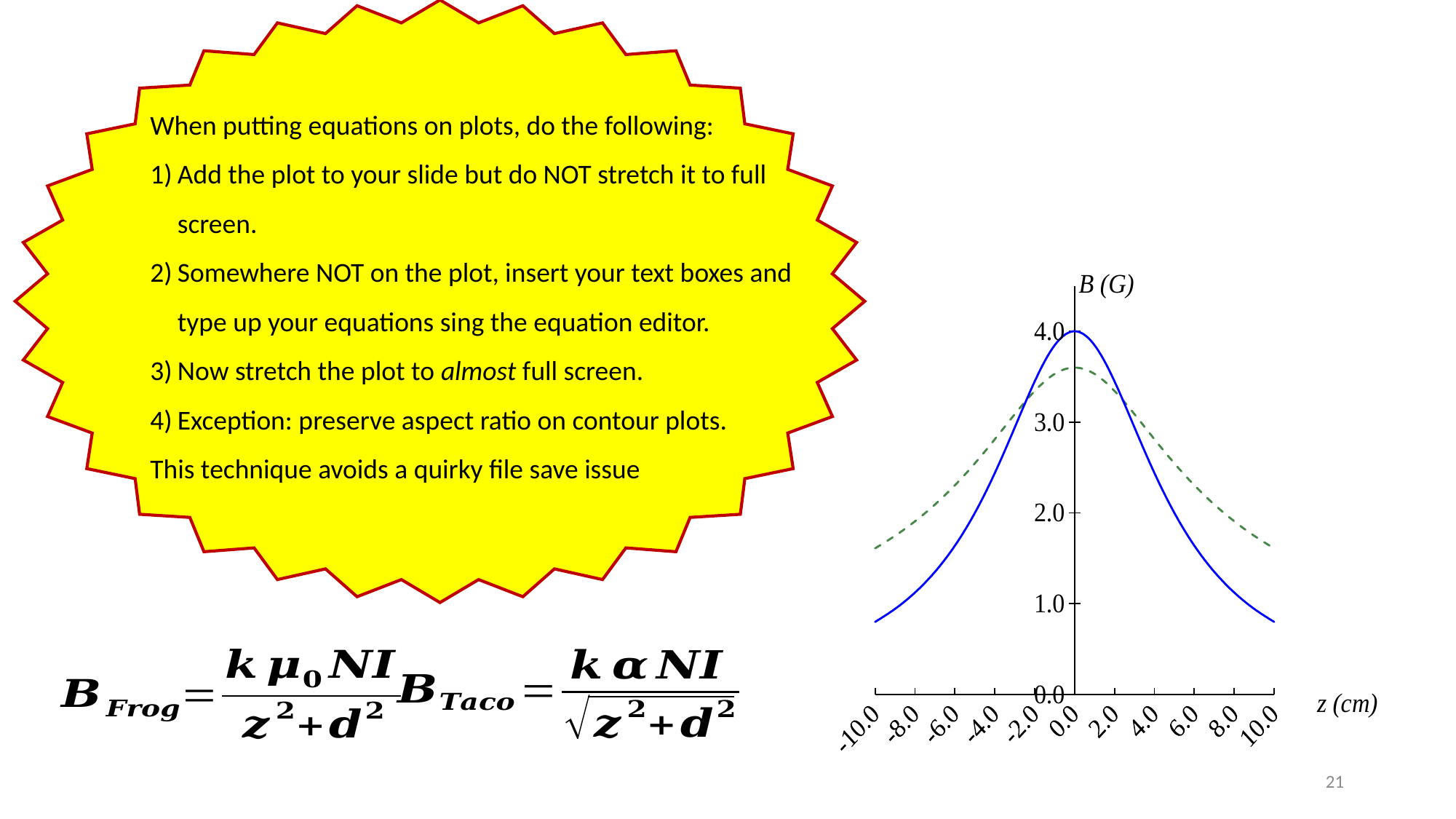
Is the value of the solid blue curve at z = 10.0 greater or less than 1.0? less At z = 10.0, which curve has the higher value, the solid blue curve or the dashed green curve? dashed green curve How many curves are plotted on the chart? 2 Is the value of the dashed green curve at z = 0.0 greater or less than 3.0? greater What kind of chart is shown on the right of the slide? line chart At z = 0.0, which curve has the higher value, the solid blue curve or the dashed green curve? solid blue curve Is the value of the dashed green curve at z = -10.0 greater or less than 1.0? greater Does the solid blue curve rise or fall as z increases from 0.0 to 10.0? fall What is the label of the horizontal axis of the chart? z (cm) What is the peak value of the solid blue curve, at z = 0.0? 4.0 What is the label of the vertical axis of the chart? B (G) How many tick labels are shown along the horizontal axis of the chart? 11